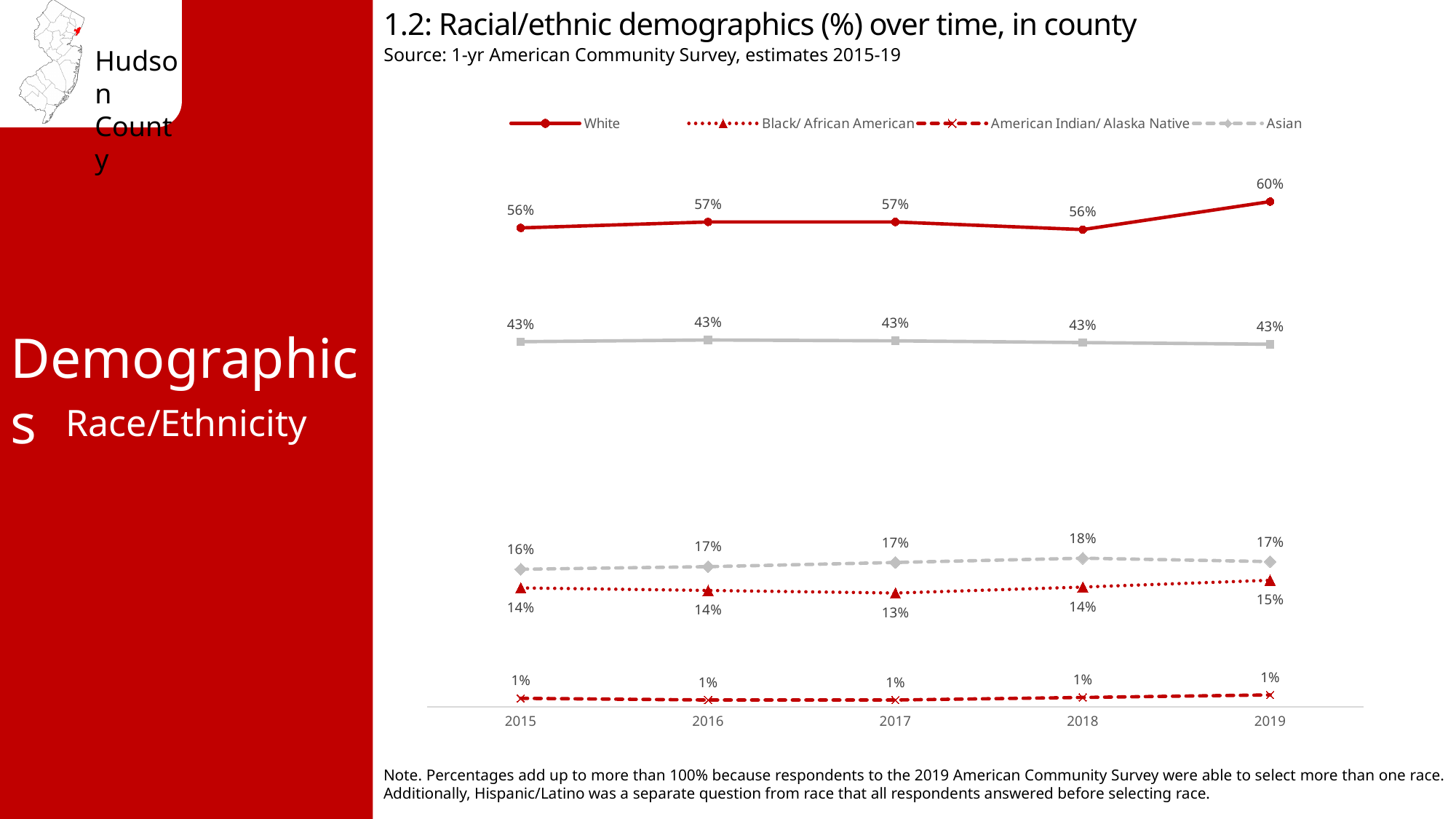
What kind of chart is this? Line chart In which year is the Black/ African American series at its lowest? 2017 What is the value for American Indian/ Alaska Native in 2015? 1% What is the title of the chart? 1.2: Racial/ethnic demographics (%) over time, in county What is the value for Asian in 2018? 18% How many years are shown on the x axis? 5 In 2016, which is larger: the Asian value or the Black/ African American value? Asian Does the White series rise or fall from 2018 to 2019? Rise By how many percentage points did the White value change from 2015 to 2019? 4 In which year is the White series at its highest? 2019 What is the value for Black/ African American in 2017? 13% What is the value for White in 2019? 60%